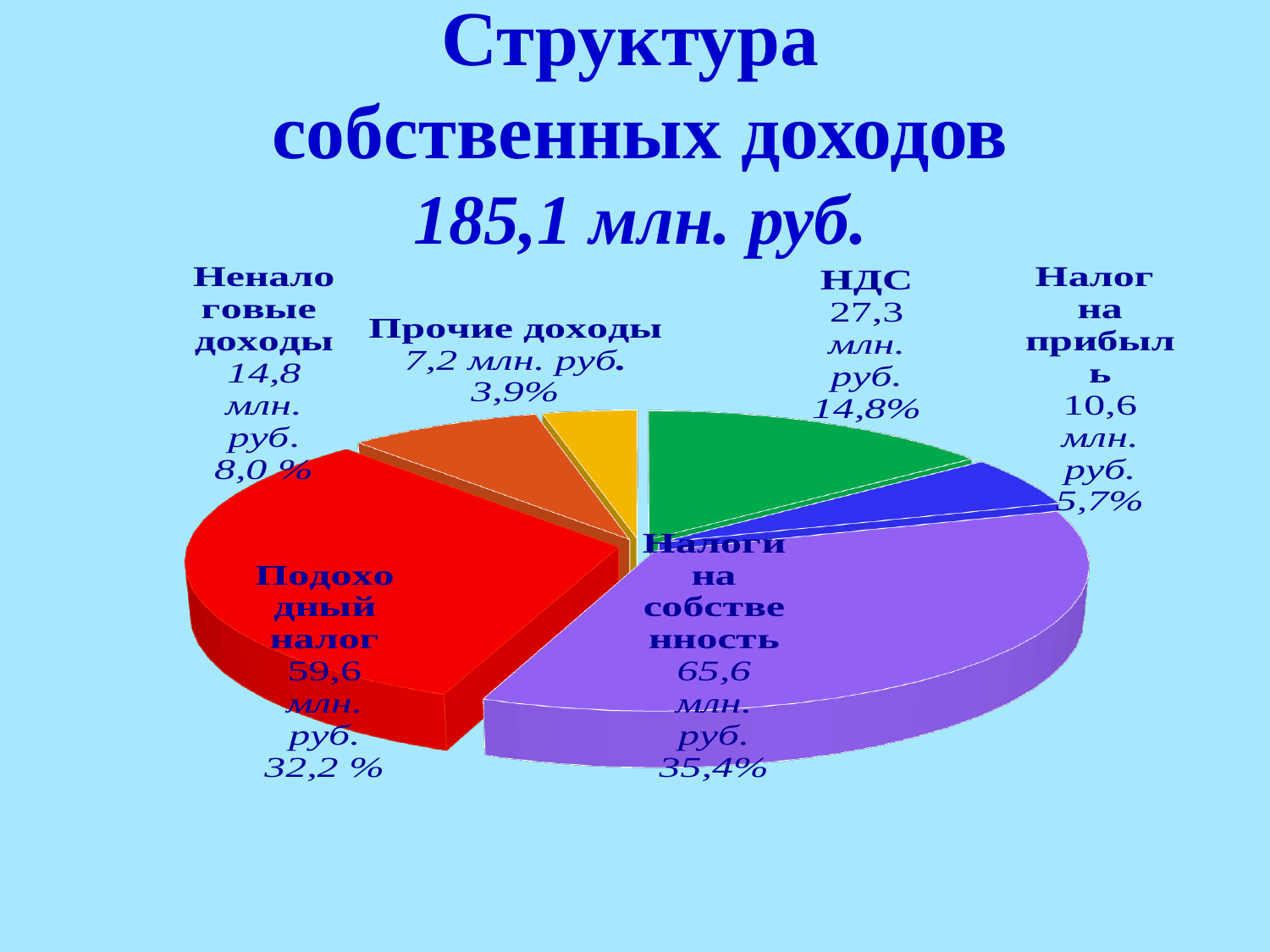
What is the difference in value between Налоги на собственность and Подоходный налог? 6,0 млн. руб. What is the value for Неналоговые доходы? 14,8 млн. руб. Which is larger, the value for НДС or the value for Налог на прибыль? НДС What share of the pie does Подоходный налог represent? 32,2 % How many slices does the pie chart have? 6 Which category has the smallest slice of the pie? Прочие доходы What share of the pie does Прочие доходы represent? 3,9% What kind of chart is shown on the slide? pie chart What is the value for Налоги на собственность? 65,6 млн. руб. What total amount is stated in the chart title? 185,1 млн. руб. What is the value for НДС? 27,3 млн. руб. Which category has the largest slice of the pie? Налоги на собственность